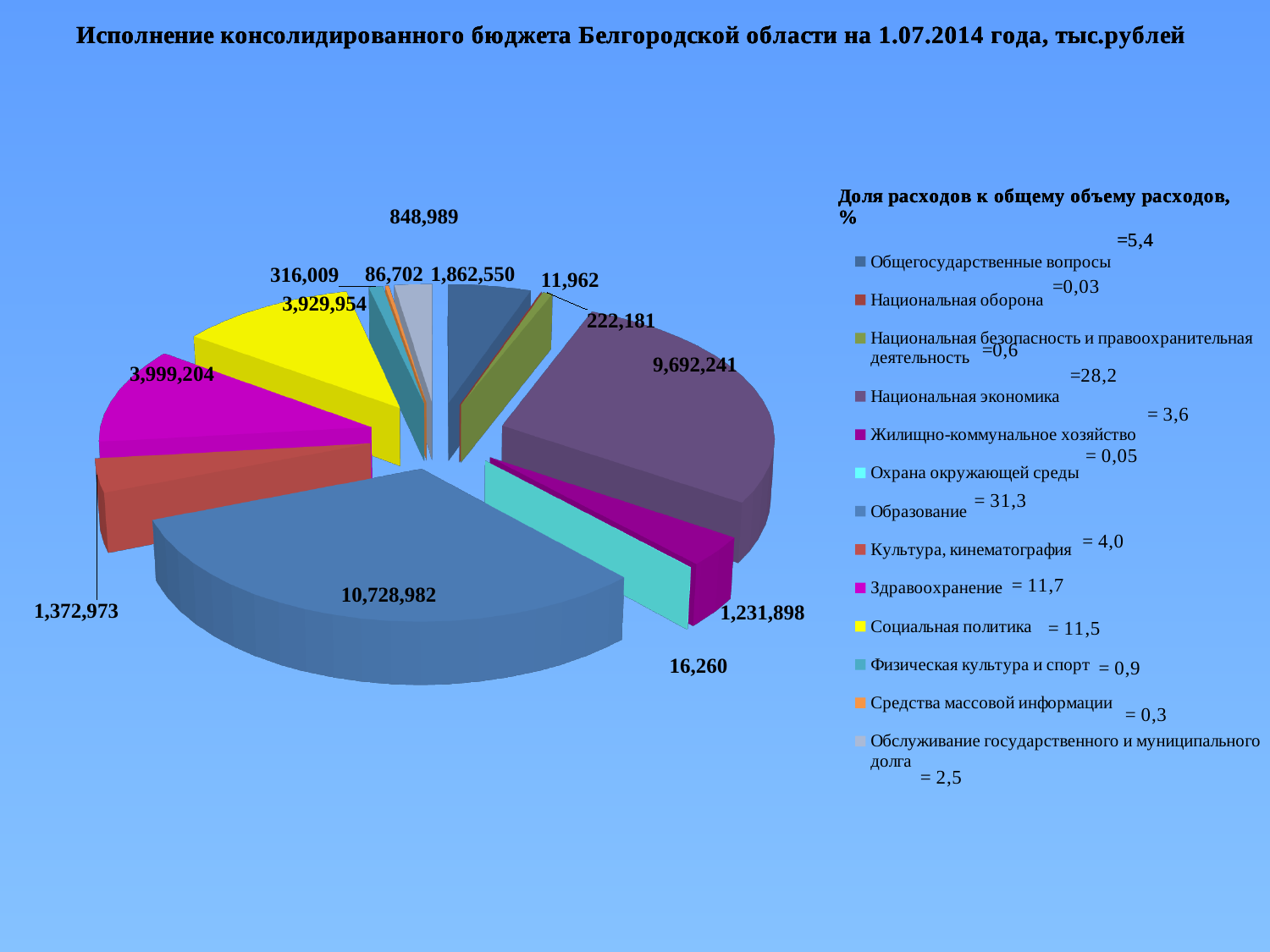
What is the value shown for the largest slice of the pie chart? 10,728,982 Which is larger, the value for Здравоохранение or the value for Социальная политика? Здравоохранение What is the difference between the values for Образование and Национальная экономика? 1,036,741 Which category has the smallest slice in the pie chart? Национальная оборона What is the value shown for Общегосударственные вопросы? 1,862,550 What type of chart is shown on the slide? pie chart According to the legend, what share of total expenditures (%) does Образование account for? 31,3 What is the value shown for Обслуживание государственного и муниципального долга? 848,989 How many categories does the legend of the pie chart list? 13 What is the value shown for Национальная экономика? 9,692,241 Which category has the largest slice in the pie chart? Образование According to the legend, what share of total expenditures (%) does Национальная экономика account for? 28,2